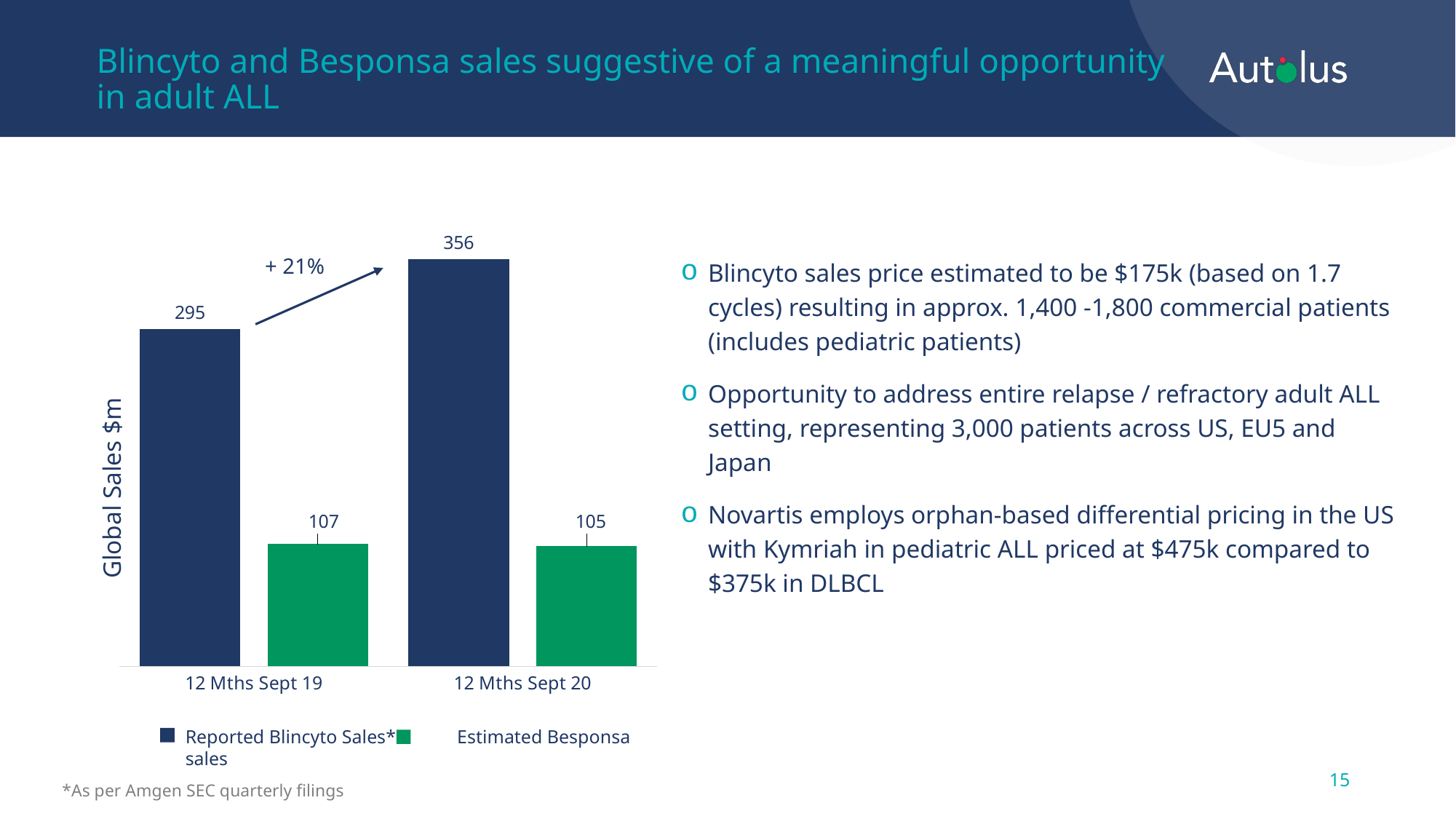
What is the Reported Blincyto Sales value for 12 Mths Sept 20? 356 What is the Estimated Besponsa sales value for 12 Mths Sept 19? 107 Do Reported Blincyto Sales rise or fall from 12 Mths Sept 19 to 12 Mths Sept 20? Rise How many categories are shown on the x axis of the chart? 2 What is the difference between Reported Blincyto Sales in 12 Mths Sept 20 and 12 Mths Sept 19? 61 What is the Reported Blincyto Sales value for 12 Mths Sept 19? 295 What is the Estimated Besponsa sales value for 12 Mths Sept 20? 105 How many series does the chart legend list? 2 What kind of chart is shown on the slide? Bar chart What percentage change is annotated on the arrow between the two Blincyto bars? + 21% Which bar in the chart has the highest value? Reported Blincyto Sales, 12 Mths Sept 20 Which is larger: Estimated Besponsa sales for 12 Mths Sept 19 or Reported Blincyto Sales for 12 Mths Sept 19? Reported Blincyto Sales for 12 Mths Sept 19